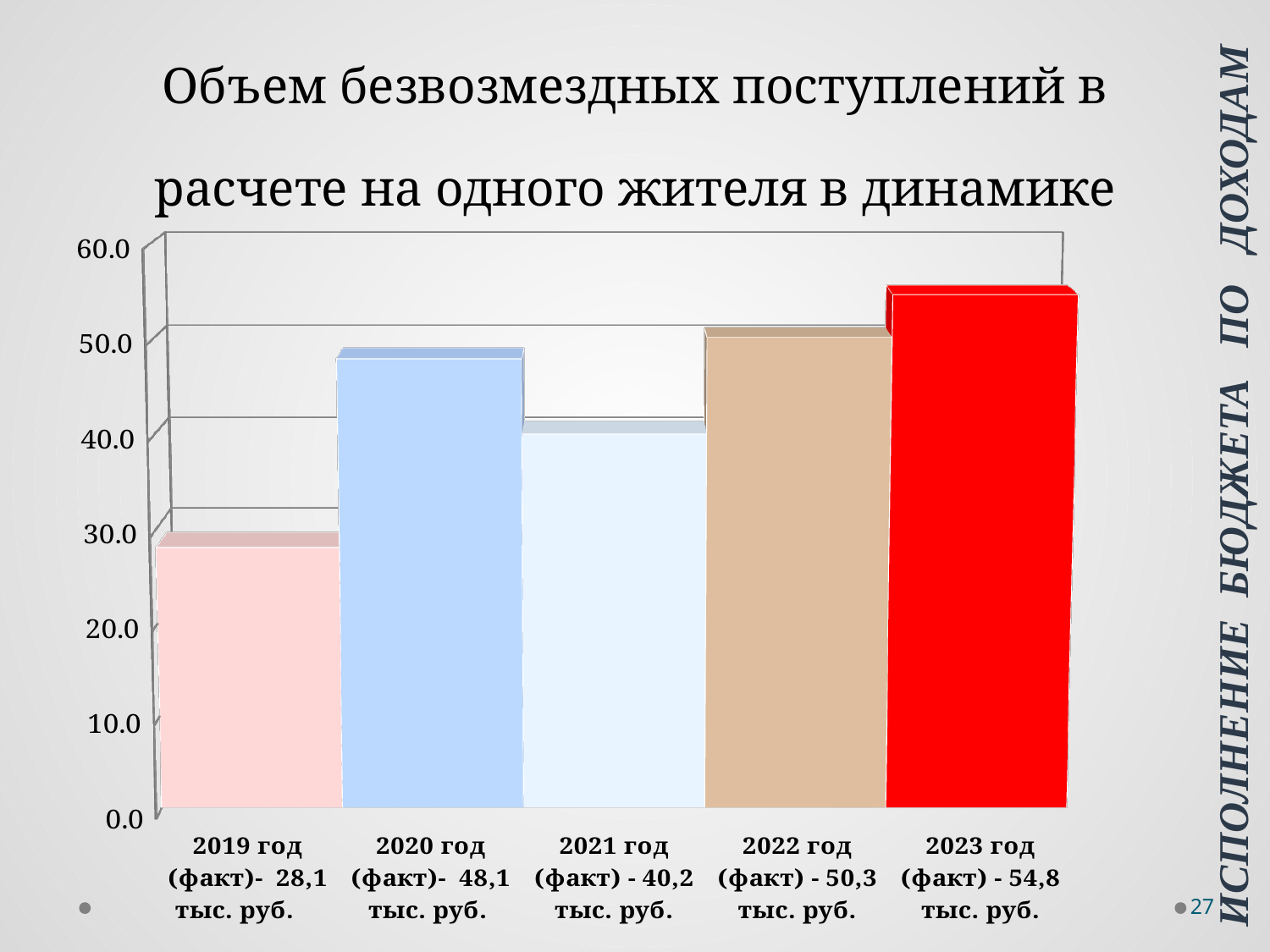
What is the value for 2023 год (факт) according to the category label? 54,8 тыс. руб. What is the difference between the values for 2023 год and 2019 год? 26,7 тыс. руб. What colour is the bar for 2023 год? red What type of chart is shown on the slide? bar chart Does the value fall or rise from 2020 год to 2021 год? fall Which year has the lowest value in the chart? 2019 год What is the value for 2021 год (факт) according to the category label? 40,2 тыс. руб. What is the value for 2019 год (факт) according to the category label? 28,1 тыс. руб. Which year has the highest value in the chart? 2023 год Which is larger, the value for 2020 год or the value for 2021 год? 2020 год How many bars (years) are shown in the chart? 5 Is the value for 2022 год greater or less than 50.0? greater